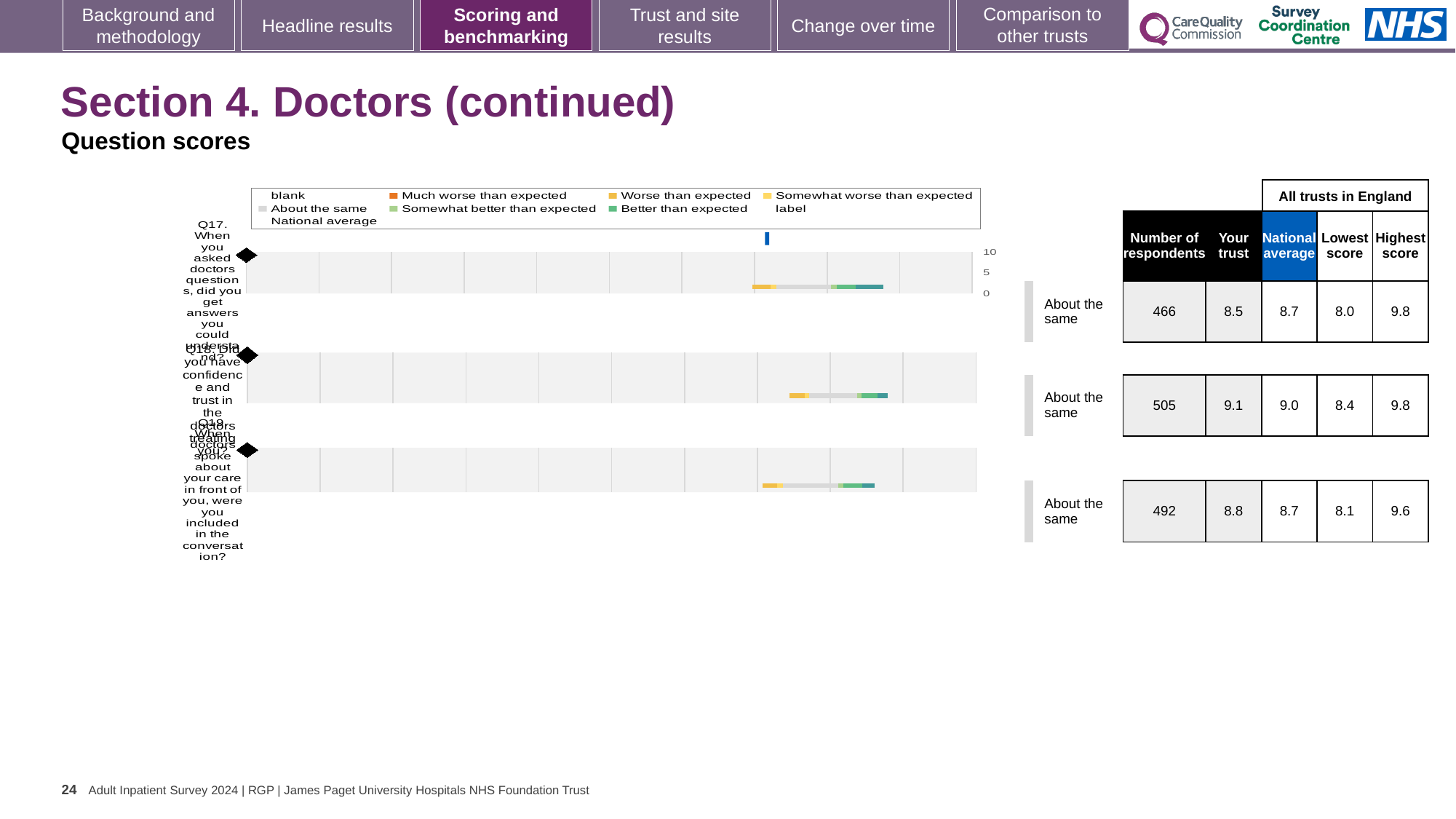
What is the highest value shown on the chart's axis? 10 What is the difference between the highest score and the lowest score for Q19 in the table? 1.5 What kind of chart is shown on the slide? bar chart In the table, what is the 'Your trust' score for Q17? 8.5 In the table, what is the national average for Q18? 9.0 What benchmark category is shown for all three questions? About the same Which of the three questions has the highest 'Your trust' score in the table? Q18 In the table, how many respondents answered Q19? 492 How many entries does the chart legend list? 9 How many questions (categories) are plotted in the chart? 3 Which of the three questions has the lowest number of respondents in the table? Q17 Is the 'Your trust' score for Q17 larger or smaller than the national average for Q17? smaller